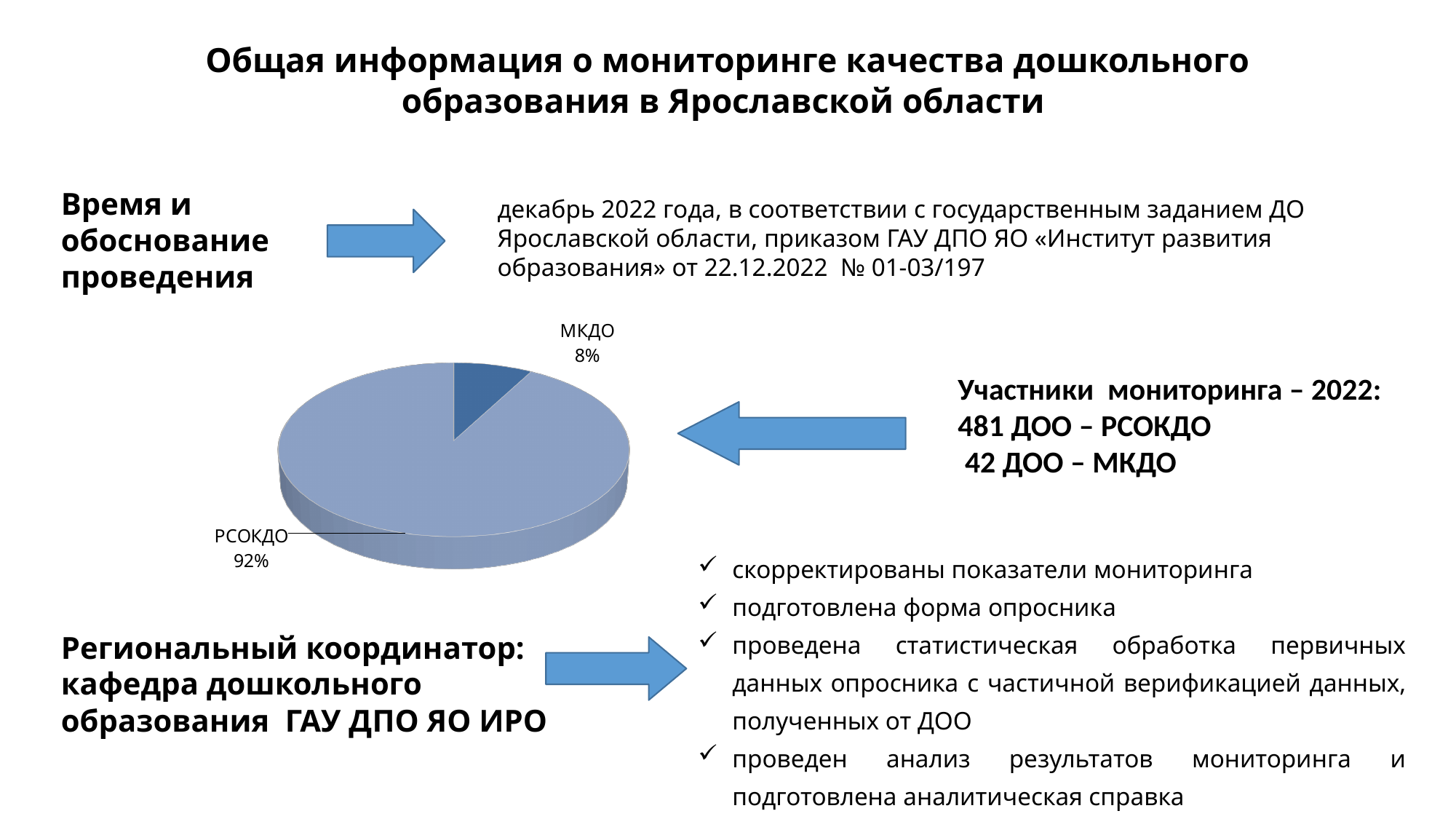
What is the total of the two slices shown in the pie chart? 100% How many slices does the pie chart have? 2 Which slice of the pie chart is the smallest? МКДО Which is larger in the pie chart, РСОКДО or МКДО? РСОКДО What kind of chart is shown on the slide? pie chart What is the difference in percentage points between the РСОКДО and МКДО slices? 84 Which slice of the pie chart is the largest? РСОКДО Which slice of the pie chart is drawn in the darker blue colour? МКДО What share of the pie does МКДО take? 8% What share of the pie does РСОКДО take? 92%